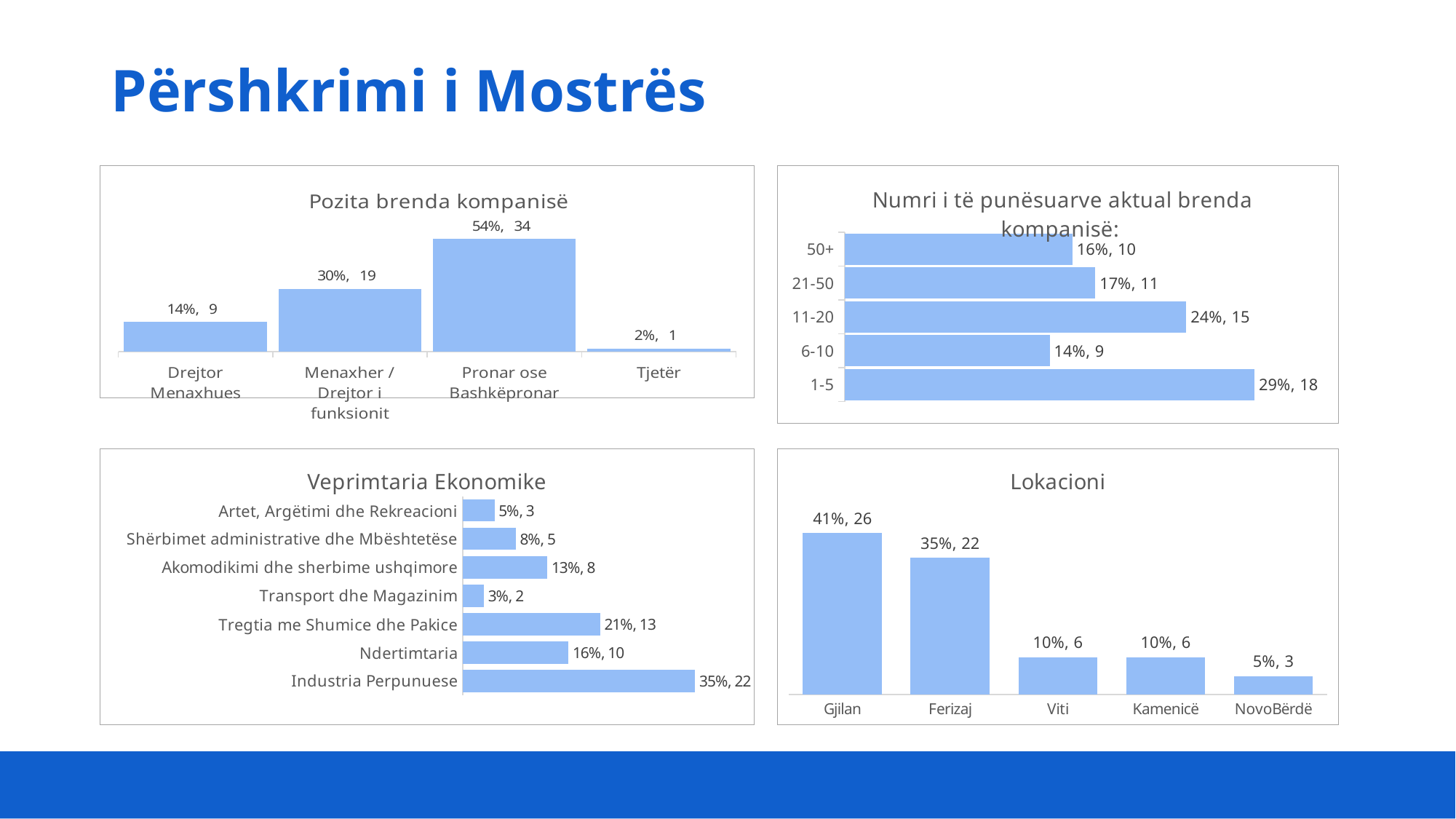
In the 'Lokacioni' chart, which is larger, the value for Viti or the value for NovoBërdë? Viti In the 'Veprimtaria Ekonomike' chart, which category has the lowest value? Transport dhe Magazinim In the 'Veprimtaria Ekonomike' chart, how many categories are shown? 7 In the 'Pozita brenda kompanisë' chart, what is the data label for 'Pronar ose Bashkëpronar'? 54%, 34 In the 'Lokacioni' chart, what is the difference in count between Gjilan and Ferizaj? 4 In the 'Lokacioni' chart, what is the data label for 'Ferizaj'? 35%, 22 What type of chart is the 'Lokacioni' chart? Bar chart In the 'Numri i të punësuarve aktual brenda kompanisë:' chart, how many categories are shown? 5 In the 'Pozita brenda kompanisë' chart, which category has the lowest value? Tjetër In the 'Veprimtaria Ekonomike' chart, what is the data label for 'Tregtia me Shumice dhe Pakice'? 21%, 13 In the 'Numri i të punësuarve aktual brenda kompanisë:' chart, which category has the highest value? 1-5 In the 'Numri i të punësuarve aktual brenda kompanisë:' chart, what is the data label for '11-20'? 24%, 15